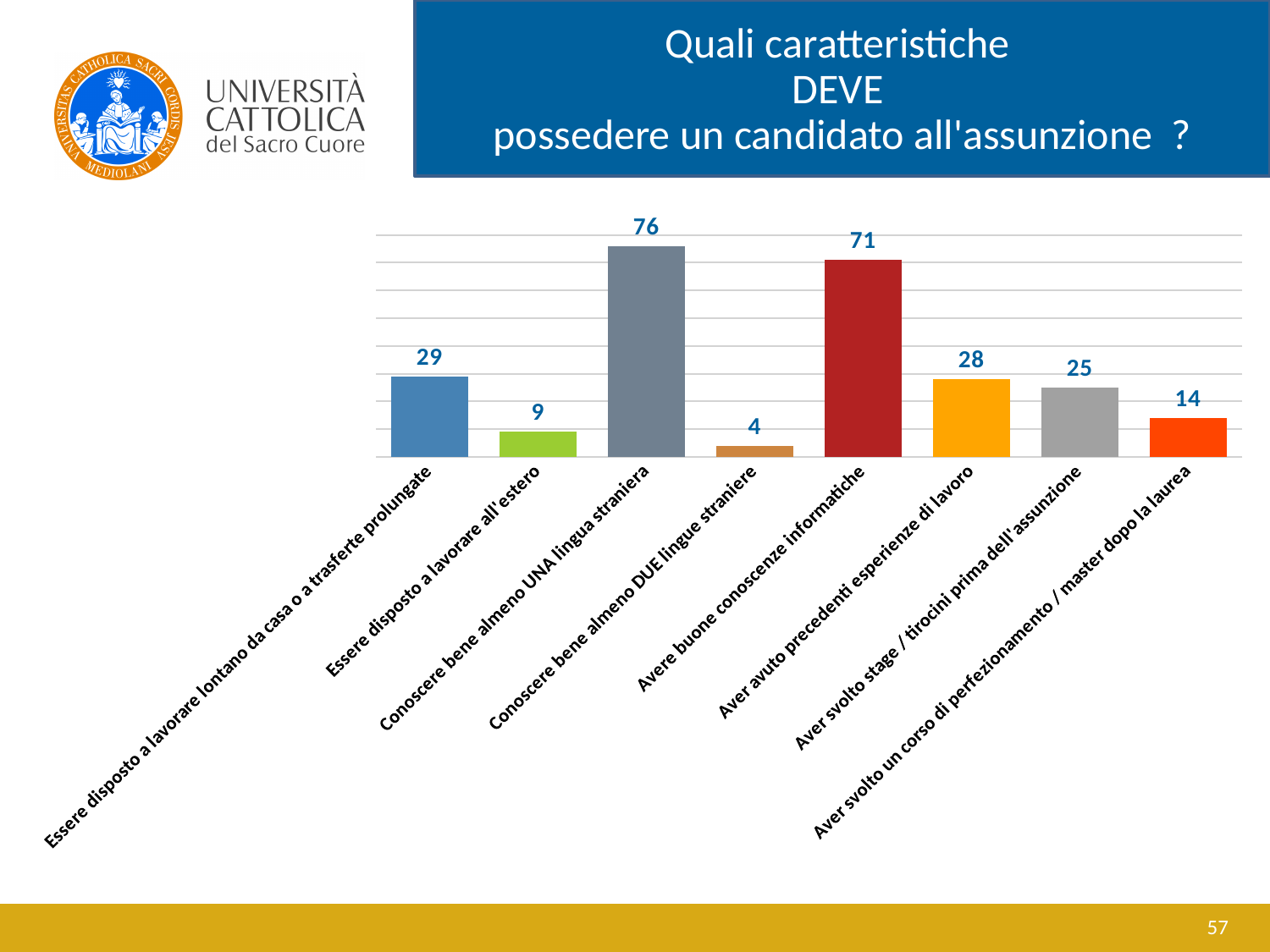
What is the value for "Aver svolto un corso di perfezionamento / master dopo la laurea"? 14 What is the value for "Conoscere bene almeno DUE lingue straniere"? 4 What is the value for "Conoscere bene almeno UNA lingua straniera"? 76 Which category has the lowest value? Conoscere bene almeno DUE lingue straniere Which category has the highest value? Conoscere bene almeno UNA lingua straniera Which is larger: the value for "Aver avuto precedenti esperienze di lavoro" or the value for "Aver svolto stage / tirocini prima dell'assunzione"? Aver avuto precedenti esperienze di lavoro What is the value for "Avere buone conoscenze informatiche"? 71 What kind of chart is shown on the slide? Bar chart How many categories are shown in the chart? 8 What colour is the bar for "Avere buone conoscenze informatiche"? Dark red What is the difference between the values for "Essere disposto a lavorare lontano da casa o a trasferte prolungate" and "Essere disposto a lavorare all'estero"? 20 What is the difference between the values for "Conoscere bene almeno UNA lingua straniera" and "Avere buone conoscenze informatiche"? 5